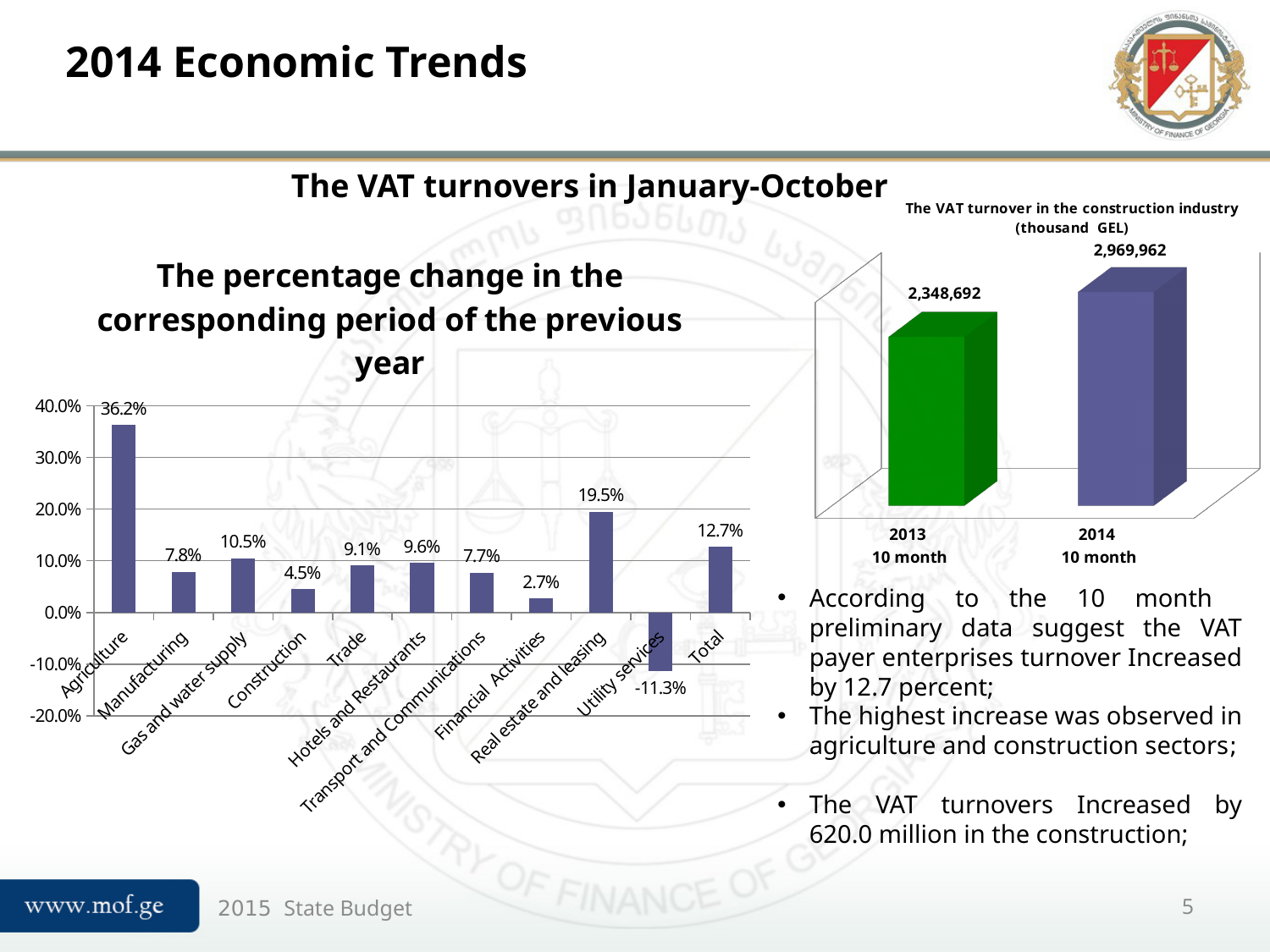
In the chart 'The VAT turnover in the construction industry (thousand GEL)', what is the difference between the 2014 10 month and 2013 10 month values? 621,270 What kind of chart is 'The percentage change in the corresponding period of the previous year'? Bar chart In the chart 'The percentage change in the corresponding period of the previous year', which category has the highest value? Agriculture In the chart 'The percentage change in the corresponding period of the previous year', what is the value for Agriculture? 36.2% In the chart 'The percentage change in the corresponding period of the previous year', which is larger: Trade or Hotels and Restaurants? Hotels and Restaurants In the chart 'The percentage change in the corresponding period of the previous year', which category has the lowest value? Utility services How many categories are shown in the chart 'The percentage change in the corresponding period of the previous year'? 11 In the chart 'The percentage change in the corresponding period of the previous year', what is the value for Utility services? -11.3% In the chart 'The percentage change in the corresponding period of the previous year', what is the value for Real estate and leasing? 19.5% In the chart 'The percentage change in the corresponding period of the previous year', what is the difference between the values for Gas and water supply and Construction? 6.0% In the chart 'The VAT turnover in the construction industry (thousand GEL)', what colour is the bar for 2013 10 month? Green In the chart 'The VAT turnover in the construction industry (thousand GEL)', what is the value for 2014 10 month? 2,969,962